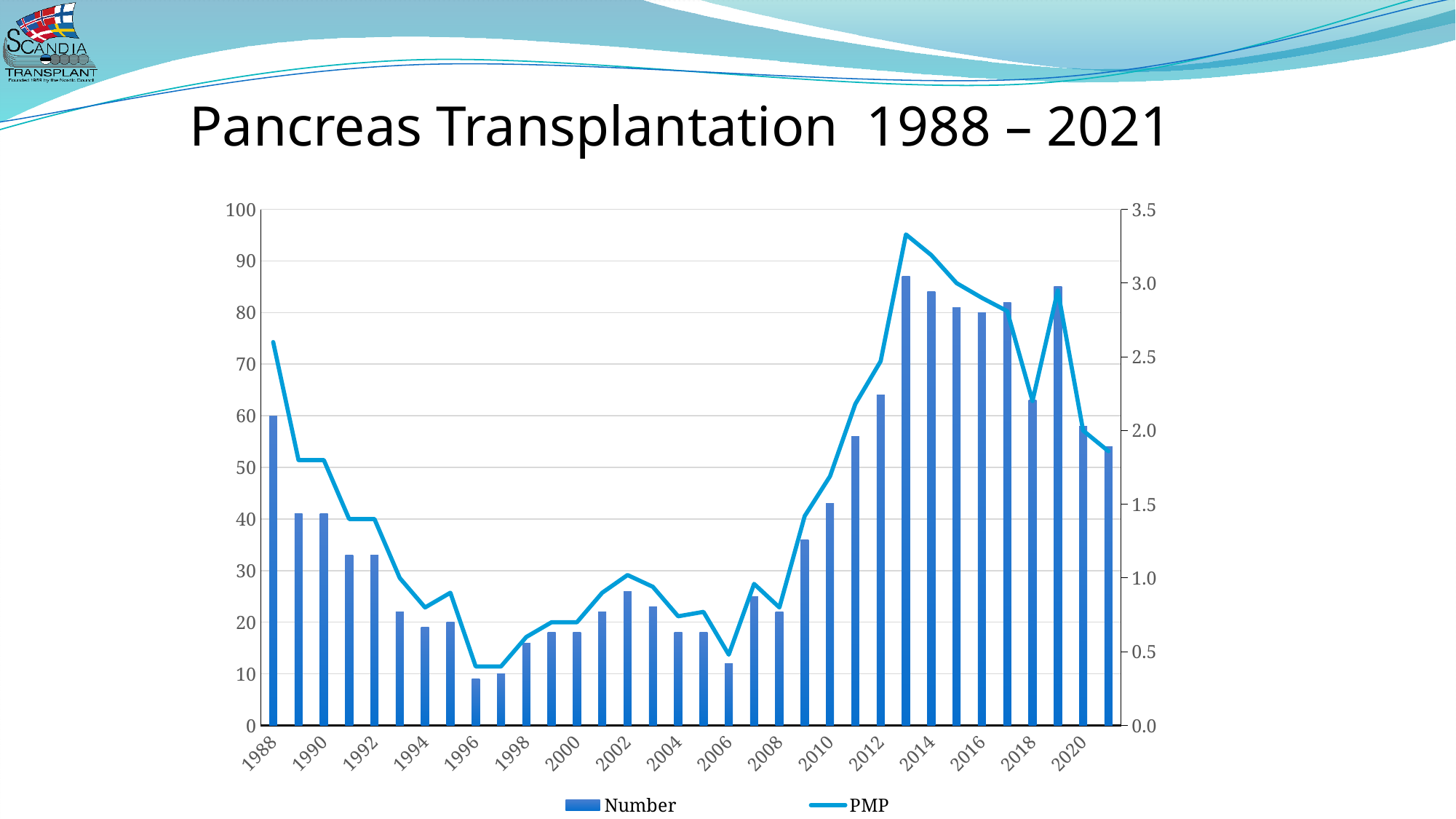
How many years (bars) are plotted on the chart? 34 Which year has the larger Number value, 1988 or 1990? 1988 Do the Number values rise or fall from 1988 to 1996? fall Is the PMP value for 2013 greater or less than 3.0? greater What are the two series named in the legend? Number and PMP Is the PMP value for 1996 greater or less than 0.5? less Is the Number value for 2013 greater or less than 80? greater How many series does the legend list? 2 What kind of chart is shown on the slide? A combined bar and line chart